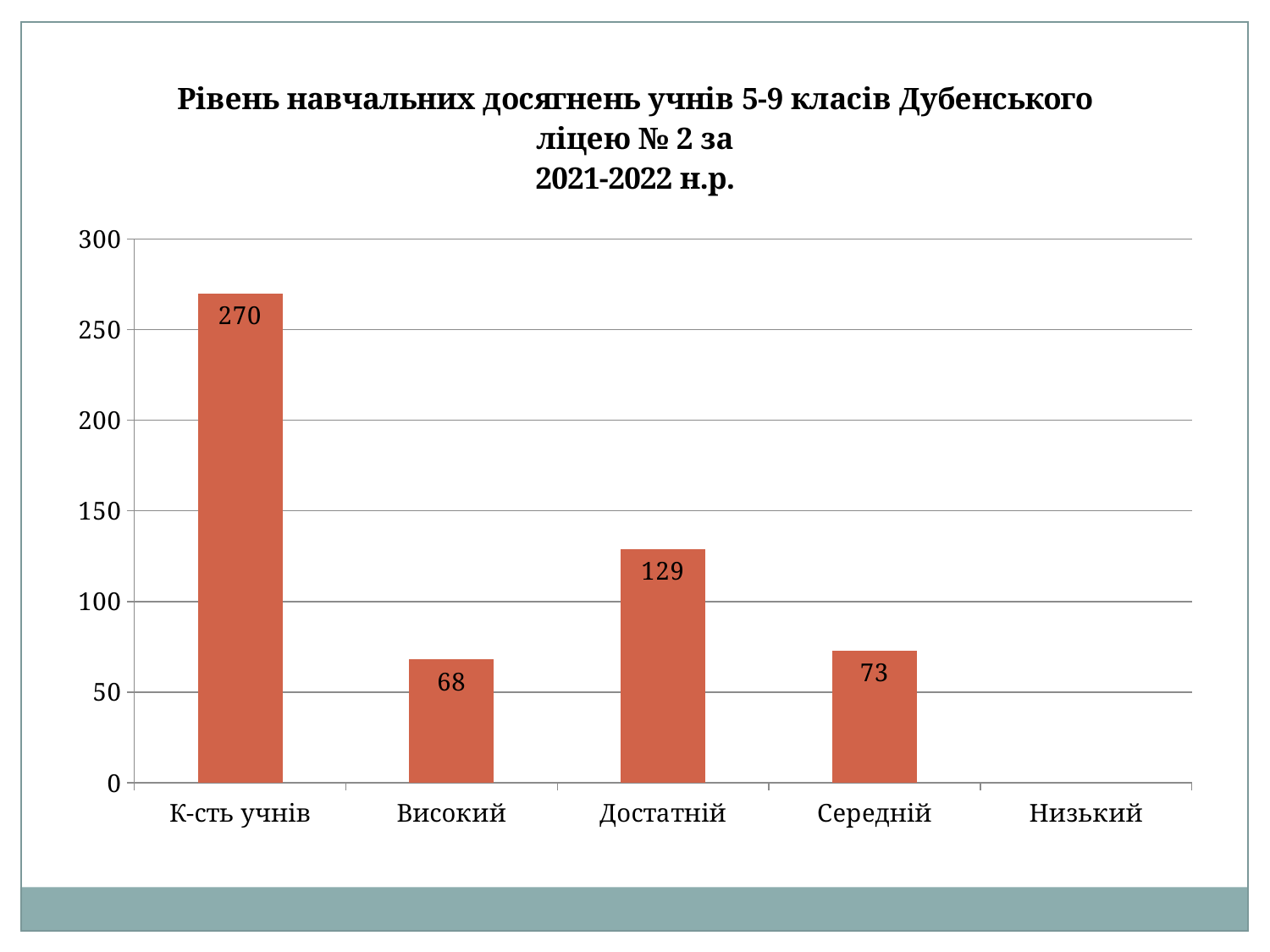
What school year does the chart title refer to? 2021-2022 н.р. Among the categories with a plotted bar, which has the lowest value? Високий Is the value for Середній greater or less than 100? less What is the difference between the values for Достатній and Високий? 61 What is the value for Високий? 68 What is the value for Достатній? 129 What is the value for Середній? 73 What is the value for К-сть учнів? 270 Which is larger, the value for Достатній or the value for Середній? Достатній How many categories are labelled on the x axis? 5 Which category has the highest value? К-сть учнів What kind of chart is shown on the slide? bar chart